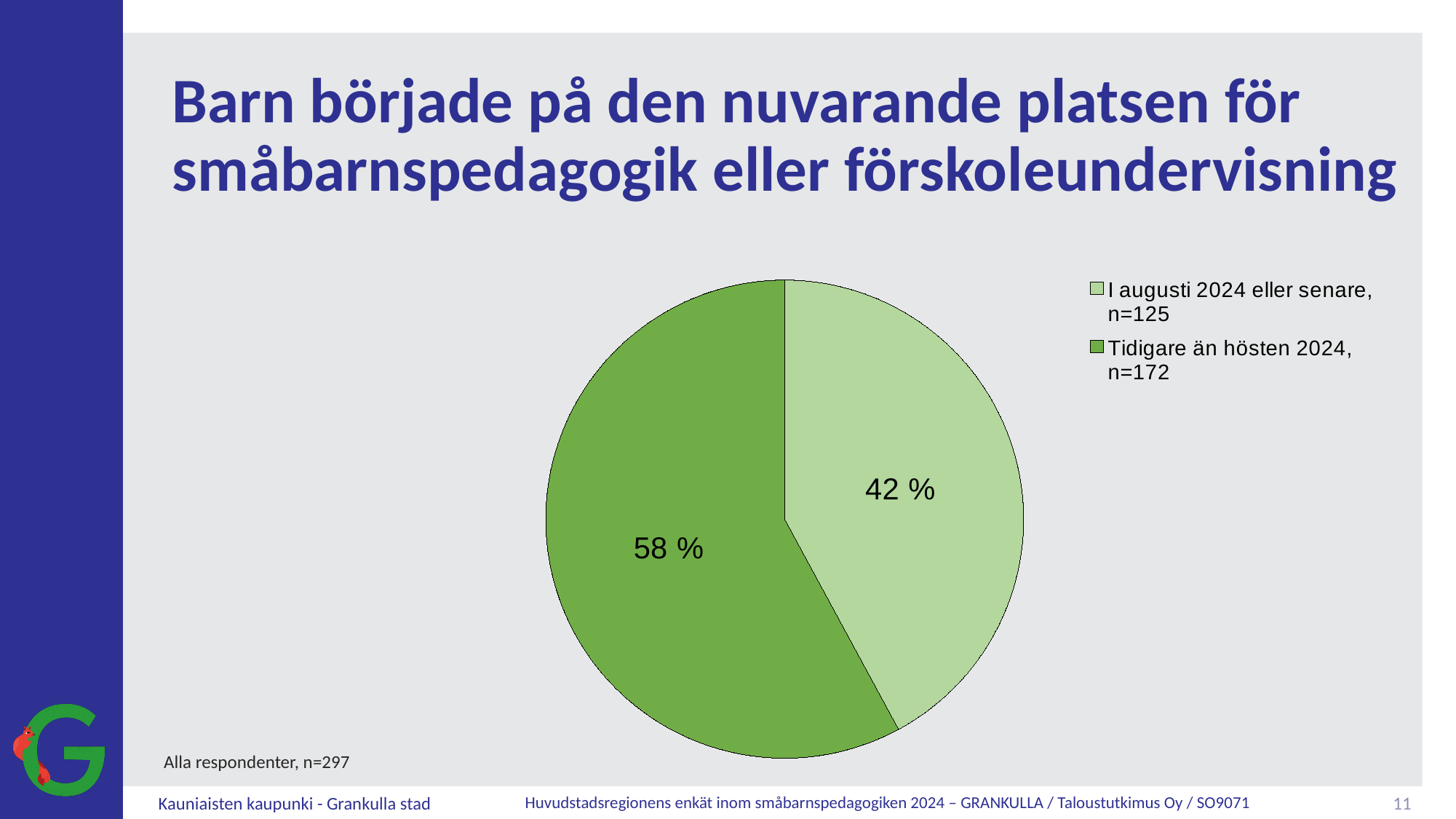
According to the legend, how many respondents are in the "I augusti 2024 eller senare" group? n=125 What share of the pie does "Tidigare än hösten 2024" represent? 58 % What is the total number of respondents stated below the chart? n=297 How many slices does the pie chart have? 2 Which is larger: the share for "I augusti 2024 eller senare" or the share for "Tidigare än hösten 2024"? Tidigare än hösten 2024 According to the legend, how many respondents are in the "Tidigare än hösten 2024" group? n=172 How many entries does the legend list? 2 Which slice is the smallest? I augusti 2024 eller senare What is the difference in percentage points between the "Tidigare än hösten 2024" slice and the "I augusti 2024 eller senare" slice? 16 percentage points What kind of chart is shown on the slide? pie chart Which slice is the largest? Tidigare än hösten 2024 What share of the pie does "I augusti 2024 eller senare" represent? 42 %